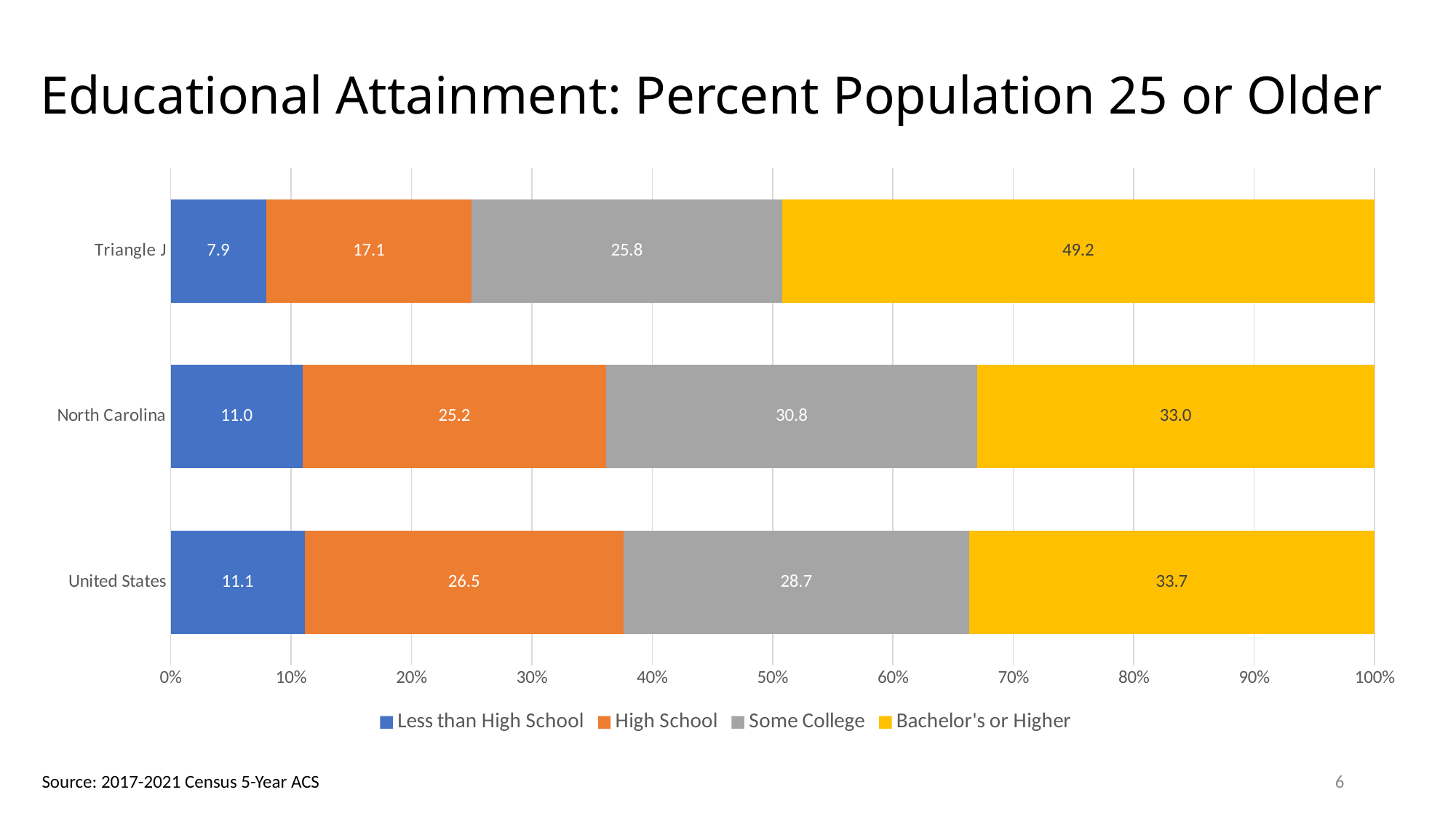
What is the Some College value for North Carolina? 30.8 What is the Bachelor's or Higher value for Triangle J? 49.2 Which region has the lowest Less than High School value? Triangle J What is the difference between the Bachelor's or Higher values for Triangle J and North Carolina? 16.2 How many regions are shown on the chart? 3 What colour represents the Some College series? Gray Which is larger, the High School value for the United States or for North Carolina? United States What kind of chart is shown on the slide? Stacked bar chart What is the High School value for North Carolina? 25.2 How many series does the legend list? 4 What is the Less than High School value for the United States? 11.1 Which region has the highest Bachelor's or Higher value? Triangle J